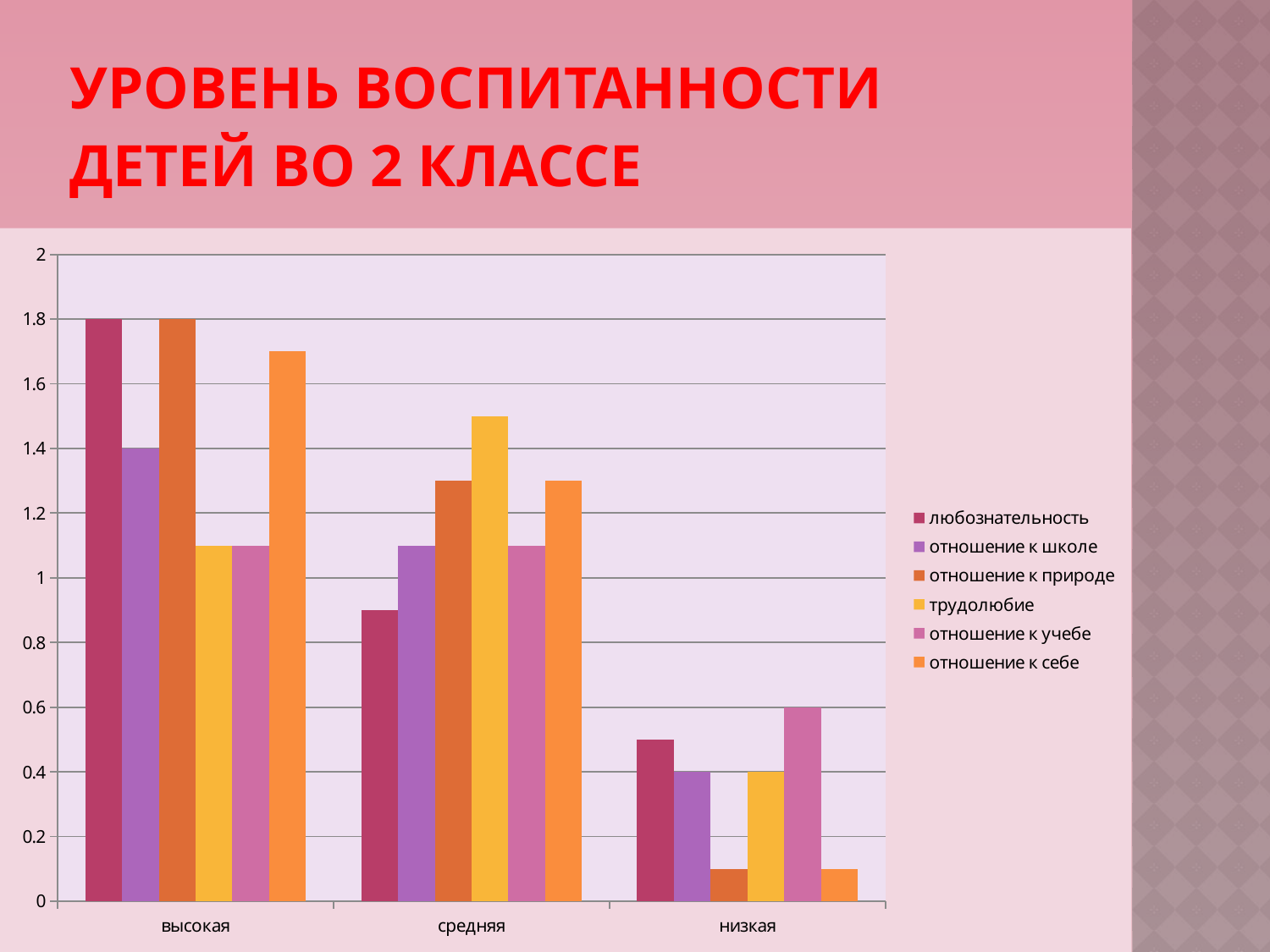
Is the value for отношение к природе in the низкая category greater or less than 0.2? less How many series does the legend list? 6 Which series has the highest value in the низкая category? отношение к учебе Which series has the highest value in the средняя category? трудолюбие How many categories are shown on the x axis? 3 Which is larger in the высокая category: отношение к себе or отношение к школе? отношение к себе What is the value for отношение к школе in the высокая category? 1.4 What is the value for любознательность in the высокая category? 1.8 Is the value for трудолюбие in the средняя category greater or less than 1.4? greater What is the value for трудолюбие in the низкая category? 0.4 What kind of chart is shown on the slide? bar chart What is the value for отношение к учебе in the низкая category? 0.6